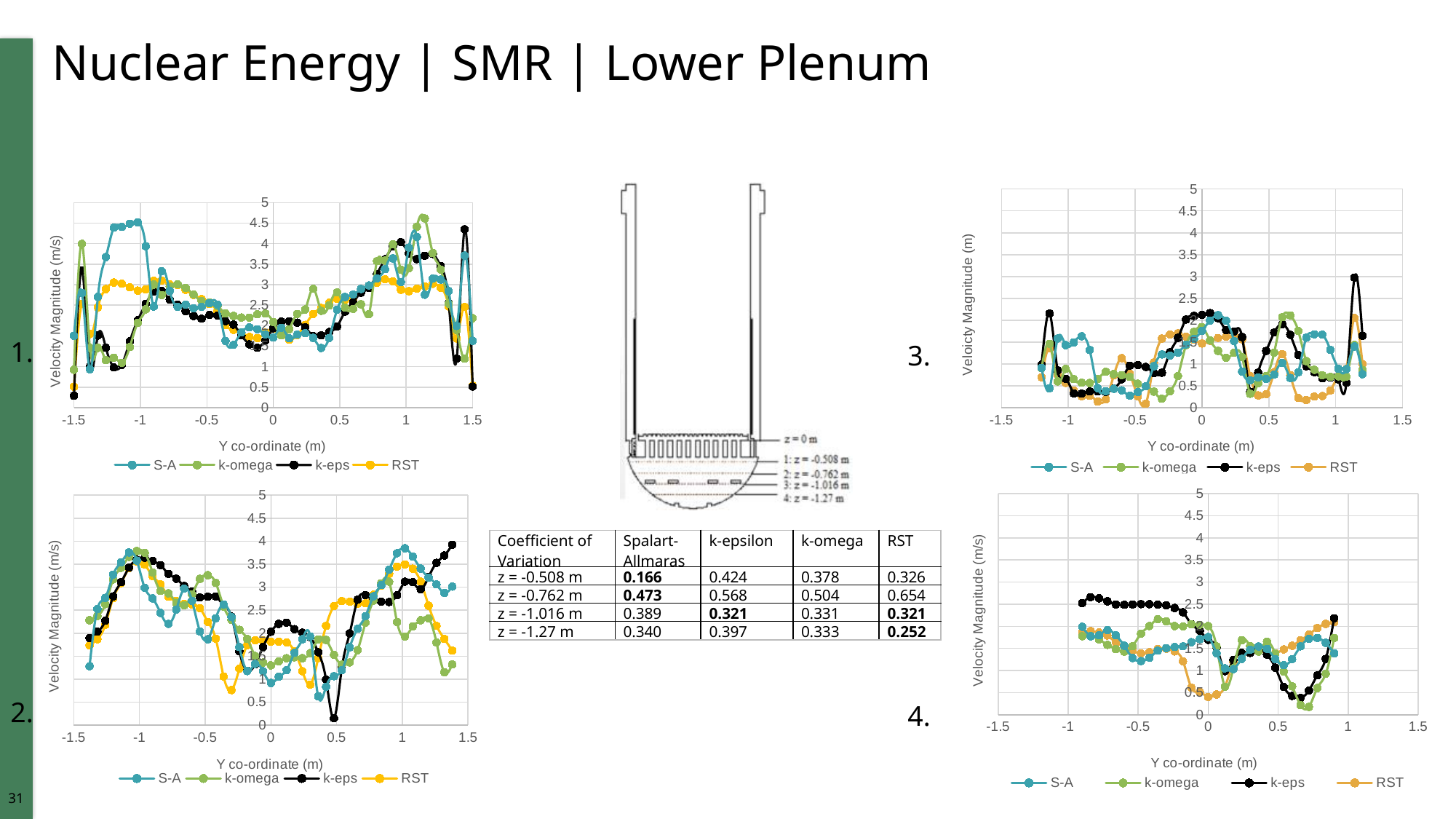
In chart 4 (bottom right), is the value of the k-eps series at Y = -0.8 m greater or less than 2? greater In chart 1 (top left), is the peak value of the S-A series near Y = -1 m greater or less than 4? greater What is the x-axis label of chart 4 (bottom right)? Y co-ordinate (m) In chart 2 (bottom left), is the value of the k-eps series at Y = 0.5 m greater or less than 0.5? less What kind of chart is chart 1 (top left)? line chart In chart 4 (bottom right), which series reaches the highest velocity magnitude? k-eps What are the legend entries of chart 3 (top right)? S-A, k-omega, k-eps, RST In chart 3 (top right), which series reaches the highest velocity magnitude? k-eps How many series does the legend of chart 2 (bottom left) list? 4